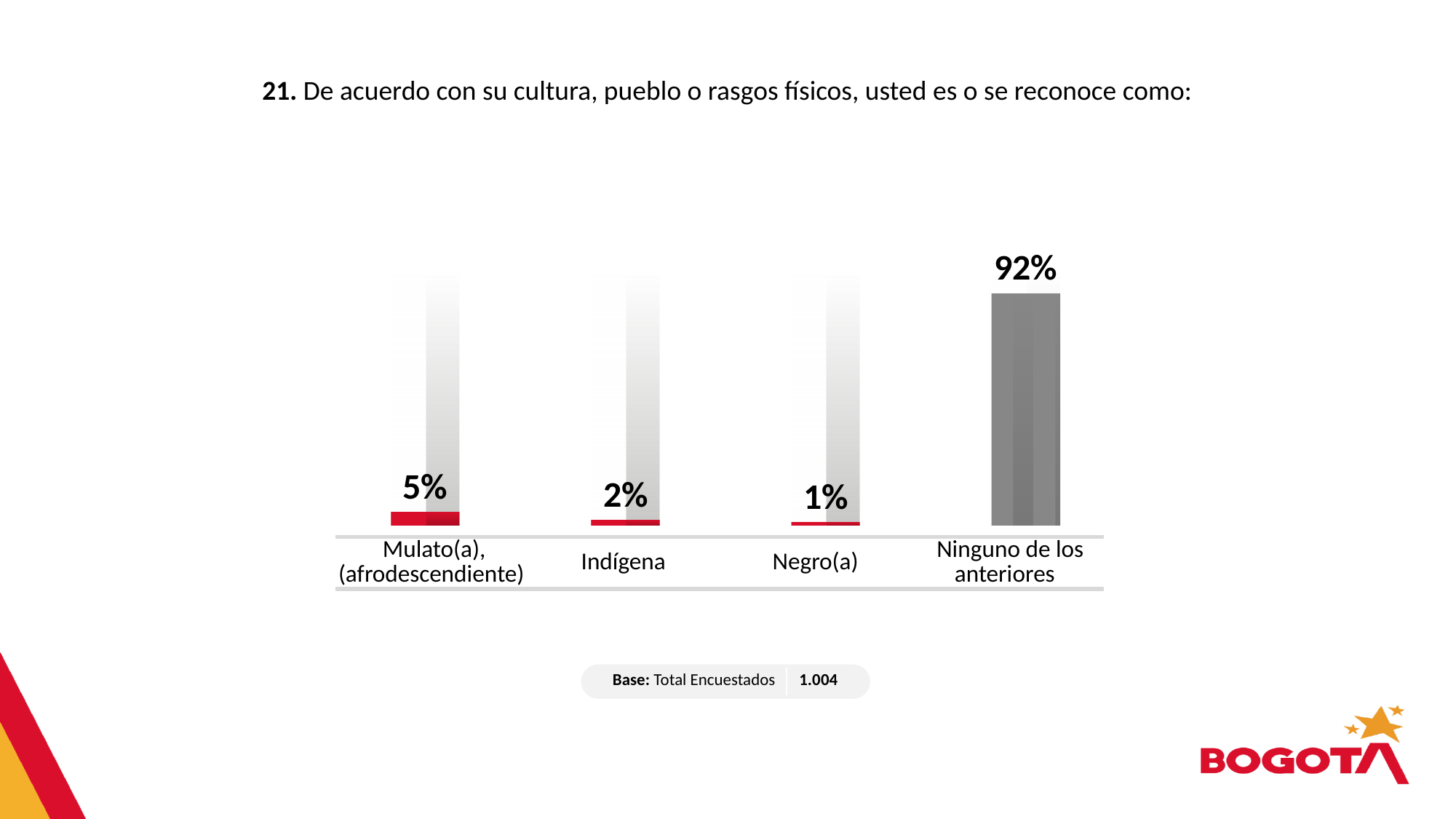
What percentage of respondents identify as Negro(a)? 1% What kind of chart is shown on the slide? Bar chart What is the base (total respondents) shown below the chart? 1.004 What percentage of respondents identify as Mulato(a), (afrodescendiente)? 5% What is the difference between the value for Mulato(a), (afrodescendiente) and the value for Indígena? 3% How many categories are shown in the chart? 4 Which category has the lowest value? Negro(a) Which is larger, the value for Indígena or the value for Negro(a)? Indígena What percentage of respondents chose 'Ninguno de los anteriores'? 92% What is the difference between the value for 'Ninguno de los anteriores' and the value for Mulato(a), (afrodescendiente)? 87% Which category has the highest value? Ninguno de los anteriores What percentage of respondents identify as Indígena? 2%